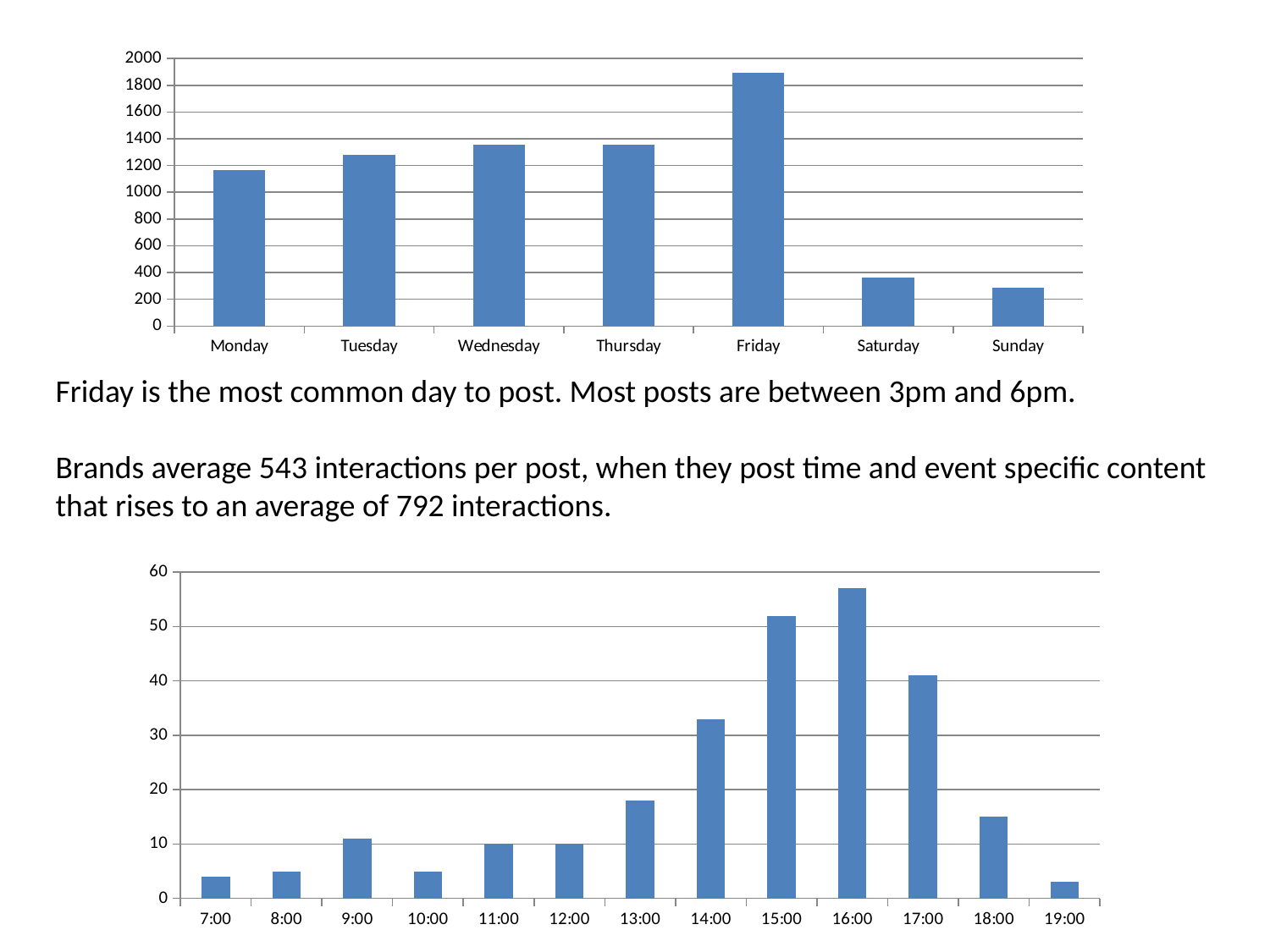
How many categories are shown on the top chart? 7 On the top chart, is the value for Monday greater or less than 1000? greater On the top chart, which day has the highest bar? Friday On the top chart, is the value for Friday greater or less than 1800? greater On the top chart, is the value for Saturday greater or less than 400? less On the bottom chart, which is larger, the value for 14:00 or the value for 17:00? 17:00 How many hourly categories are shown on the bottom chart? 13 On the top chart, which day has the lowest bar? Sunday On the bottom chart, which hour has the highest bar? 16:00 What kind of chart is the bottom chart? bar chart On the top chart, which is larger, the value for Tuesday or the value for Monday? Tuesday